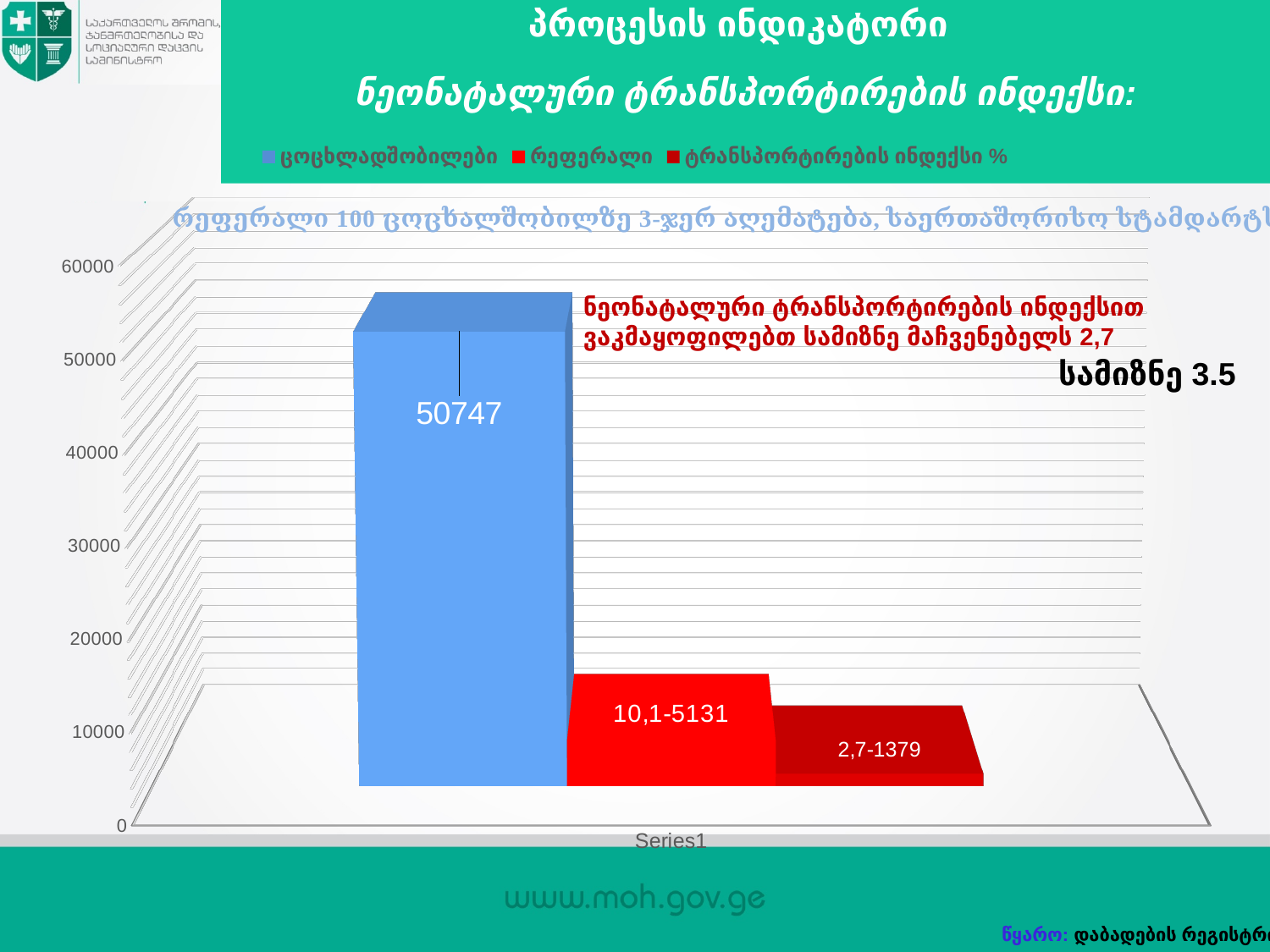
Is the value for რეფერალი greater or less than 10000? less Which series has the tallest bar in the chart? ცოცხლადშობილები Which series has the shortest bar in the chart? ტრანსპორტირების ინდექსი % What is the data label shown on the bar for ტრანსპორტირების ინდექსი %? 2,7-1379 What is the data label shown on the bar for ცოცხლადშობილები? 50747 How many series does the chart legend list? 3 Is the value for ცოცხლადშობილები greater or less than 50000? greater What label is shown on the horizontal axis of the chart? Series1 What kind of chart is shown on the slide? bar chart Which bar is taller: რეფერალი or ტრანსპორტირების ინდექსი %? რეფერალი What is the data label shown on the bar for რეფერალი? 10,1-5131 How many bars are plotted in the chart? 3